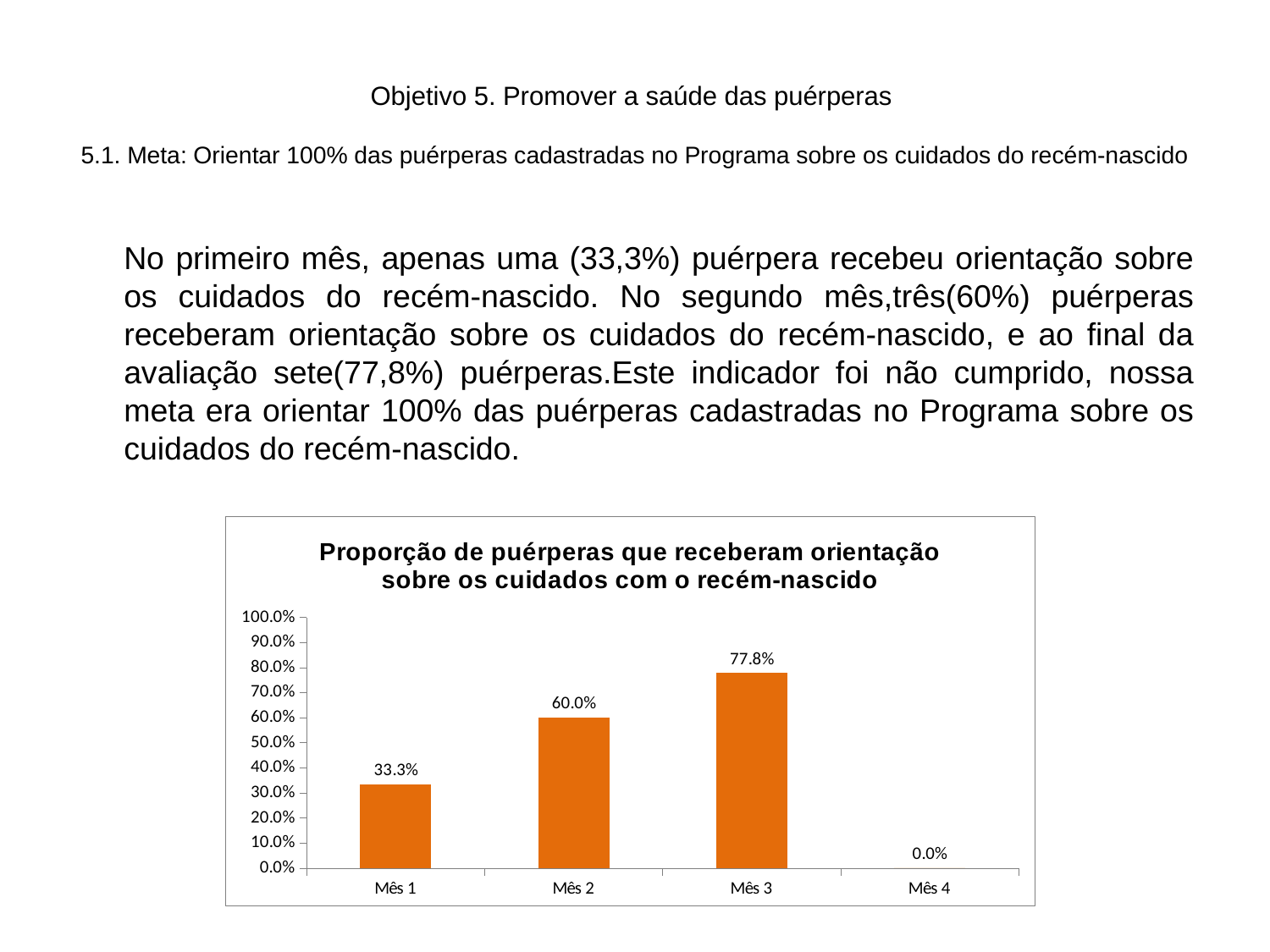
What is the value for Mês 2? 60.0% What is the value for Mês 1? 33.3% What is the title of the chart? Proporção de puérperas que receberam orientação sobre os cuidados com o recém-nascido Which is larger, the value for Mês 1 or the value for Mês 2? Mês 2 How many categories are shown on the x axis? 4 Which category has the highest value? Mês 3 Which category has the lowest value? Mês 4 What kind of chart is shown on the slide? bar chart Is the value for Mês 3 greater or less than 70.0%? greater What is the difference between the values for Mês 3 and Mês 2? 17.8% What is the value for Mês 4? 0.0% What is the value for Mês 3? 77.8%